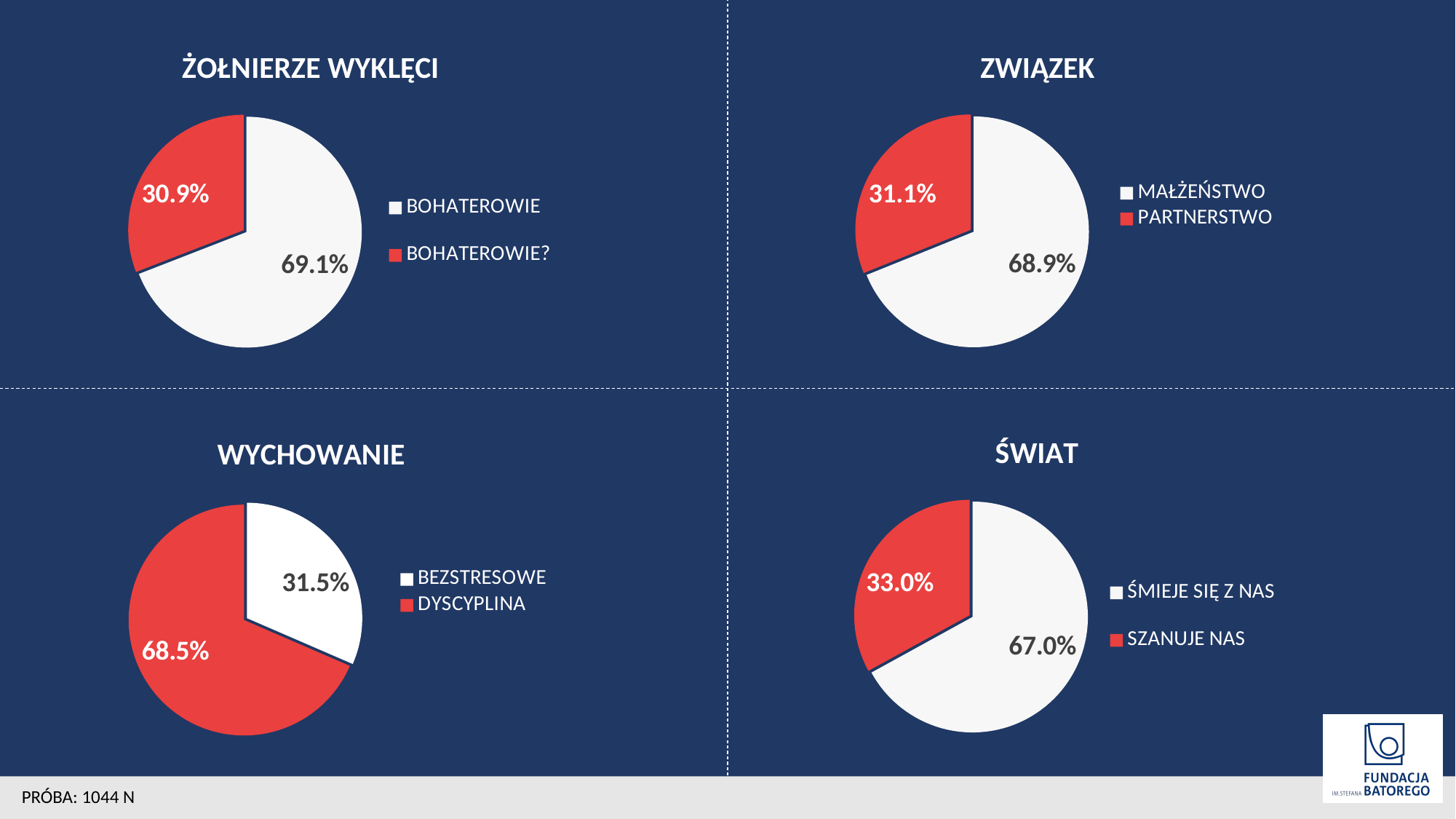
How many slices does the WYCHOWANIE pie chart have? 2 In the ŚWIAT pie chart, what is the difference between the ŚMIEJE SIĘ Z NAS and SZANUJE NAS shares? 34.0% What type of chart is used in the ŚWIAT chart? Pie chart In the ZWIĄZEK pie chart, which slice is larger, MAŁŻEŃSTWO or PARTNERSTWO? MAŁŻEŃSTWO In the WYCHOWANIE pie chart, which slice is the largest? DYSCYPLINA In the ŚWIAT pie chart, what share is labelled for ŚMIEJE SIĘ Z NAS? 67.0% In the ŻOŁNIERZE WYKLĘCI pie chart, what share is labelled for BOHATEROWIE?? 30.9% In the WYCHOWANIE pie chart, what share is labelled for DYSCYPLINA? 68.5% In the ZWIĄZEK pie chart, what share is labelled for PARTNERSTWO? 31.1% In the ZWIĄZEK pie chart, what is the difference between the MAŁŻEŃSTWO and PARTNERSTWO shares? 37.8% In the ŻOŁNIERZE WYKLĘCI pie chart, what share is labelled for BOHATEROWIE? 69.1% In the WYCHOWANIE pie chart, what share is labelled for BEZSTRESOWE? 31.5%